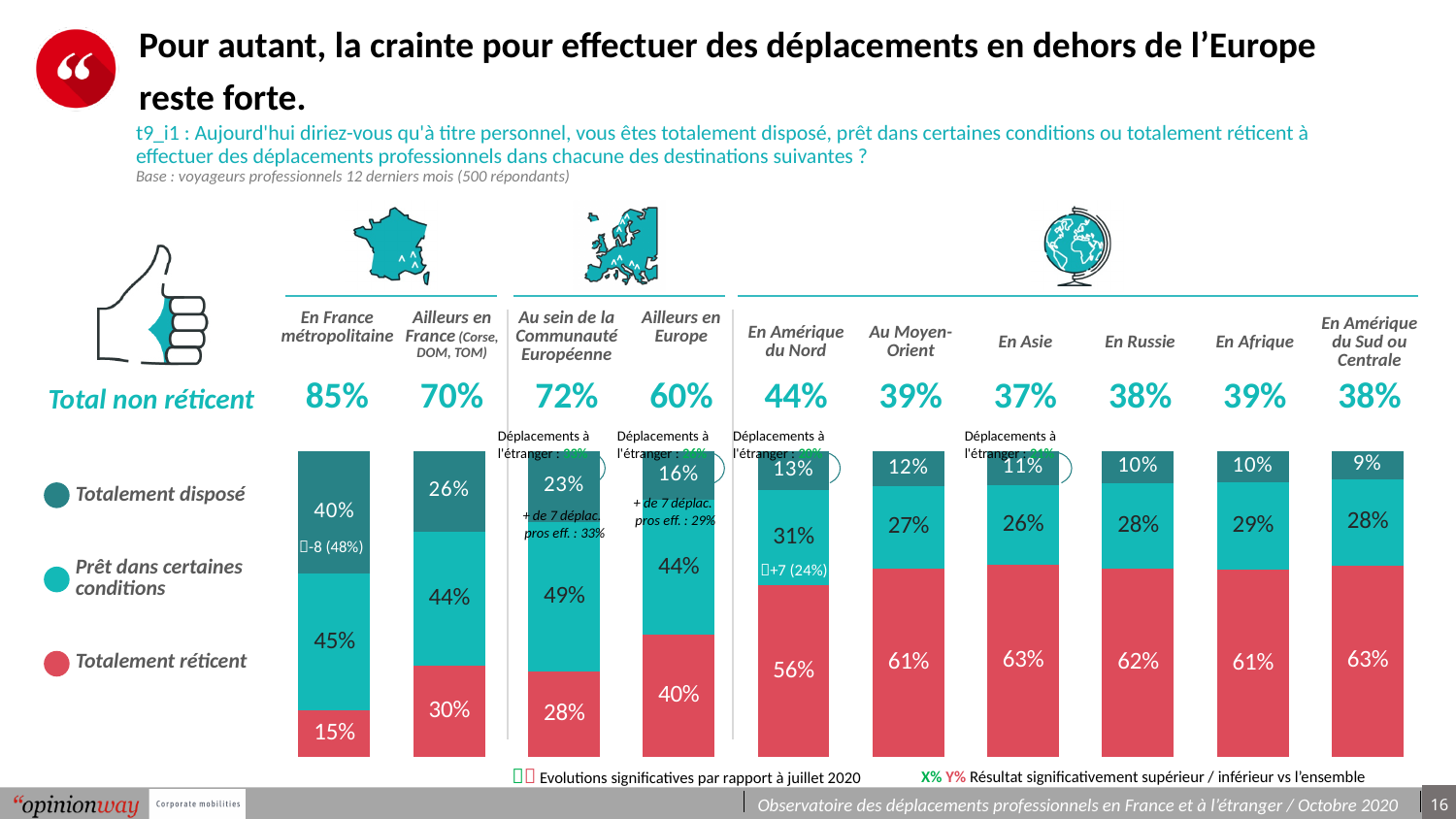
How many destinations are shown in the chart? 10 What is the 'Totalement disposé' value for 'Ailleurs en Europe'? 16% Which is larger: the 'Totalement disposé' value for 'En France métropolitaine' or for 'Ailleurs en France'? En France métropolitaine Which destination has the highest 'Totalement réticent' share? En Asie and En Amérique du Sud ou Centrale (63%) What is the total of the 'Totalement disposé' and 'Prêt dans certaines conditions' segments for 'En Russie'? 38% What is the difference between the 'Totalement réticent' values for 'Ailleurs en Europe' and 'Au sein de la Communauté Européenne'? 12 percentage points Which destination has the lowest 'Totalement disposé' share? En Amérique du Sud ou Centrale How many series does the legend list? 3 What percentage of respondents are 'Totalement réticent' for 'En France métropolitaine'? 15% What kind of chart is shown on the slide? Stacked bar chart What is the 'Prêt dans certaines conditions' value for 'En Amérique du Nord'? 31% What is the 'Total non réticent' value shown for 'Au sein de la Communauté Européenne'? 72%